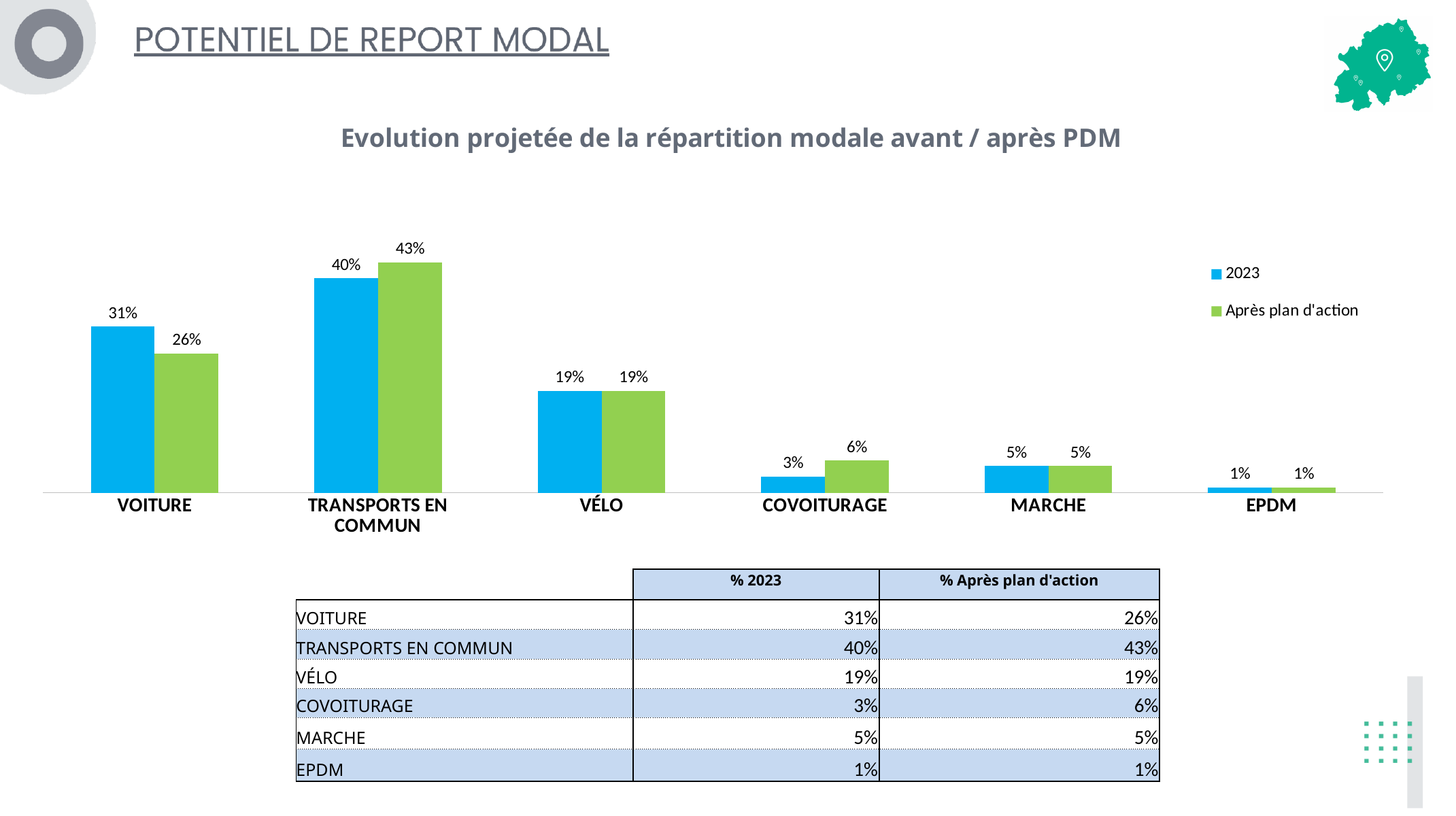
How many series does the legend list? 2 Which colour represents the 2023 series in the chart? Blue What is the title of the chart? Evolution projetée de la répartition modale avant / après PDM How many categories are shown on the x axis of the chart? 6 Which is larger for COVOITURAGE: the 2023 value or the Après plan d'action value? Après plan d'action What is the difference between the 2023 and Après plan d'action values for VOITURE? 5% What is the value for COVOITURAGE in the 2023 series? 3% What kind of chart is shown on the slide? Bar chart Which category has the highest value in the Après plan d'action series? TRANSPORTS EN COMMUN Which category has the lowest value in the 2023 series? EPDM What is the value for TRANSPORTS EN COMMUN in the Après plan d'action series? 43% What is the value for VOITURE in the 2023 series? 31%